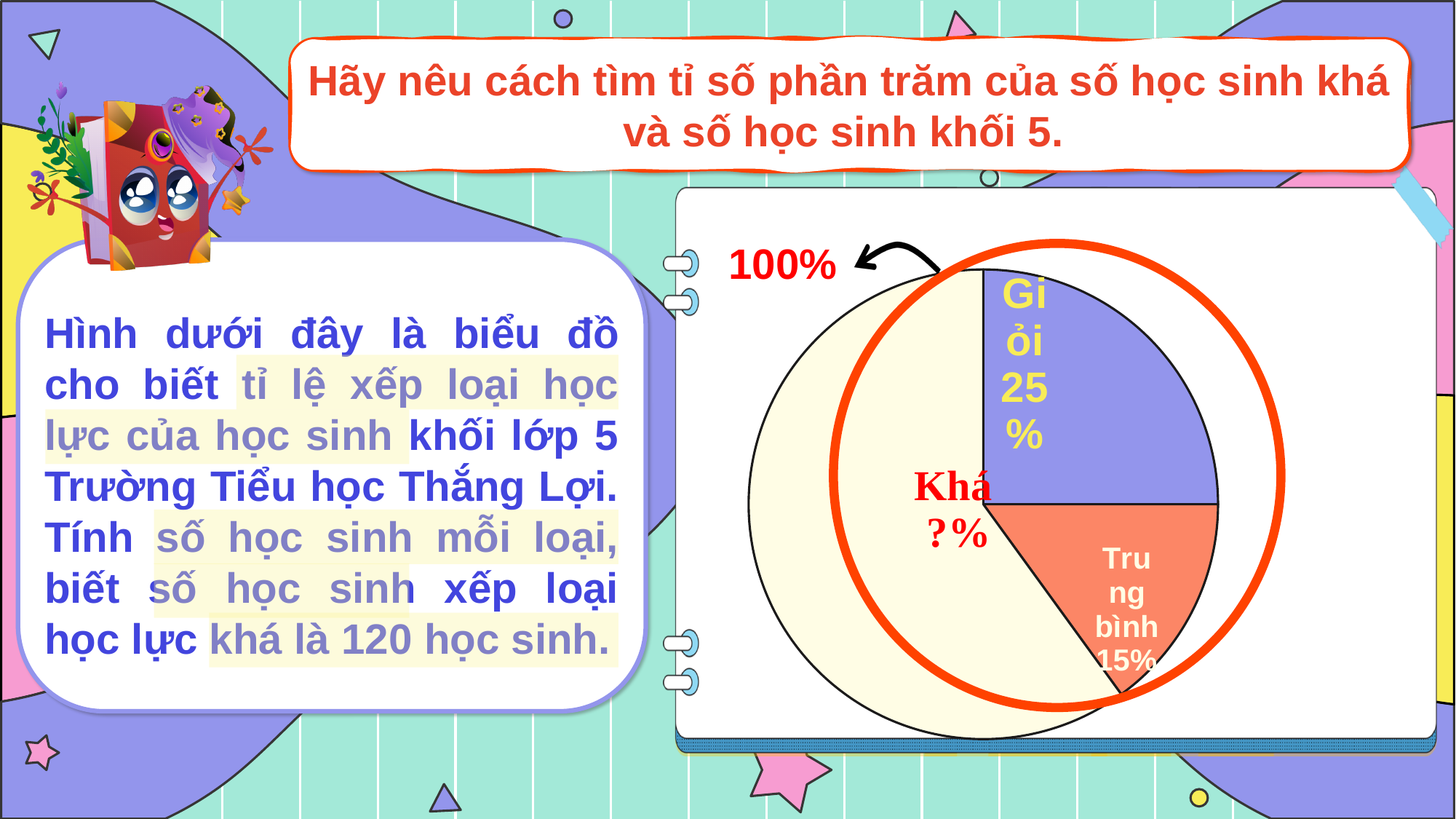
What percentage is shown for the Trung bình slice of the pie chart? 15% What percentage is shown for the Giỏi slice of the pie chart? 25% Which slice is larger, Giỏi or Trung bình? Giỏi What kind of chart is shown on the slide? pie chart What colour is the Giỏi slice of the pie chart? blue What symbol is printed in place of the percentage for the Khá slice? ? How many slices does the pie chart have? 3 Given the whole pie is 100%, Giỏi is 25% and Trung bình is 15%, what share of the pie is Khá? 60% What is the difference between the Giỏi percentage and the Trung bình percentage? 10% Which slice of the pie chart is the largest? Khá Which slice of the pie chart is the smallest? Trung bình